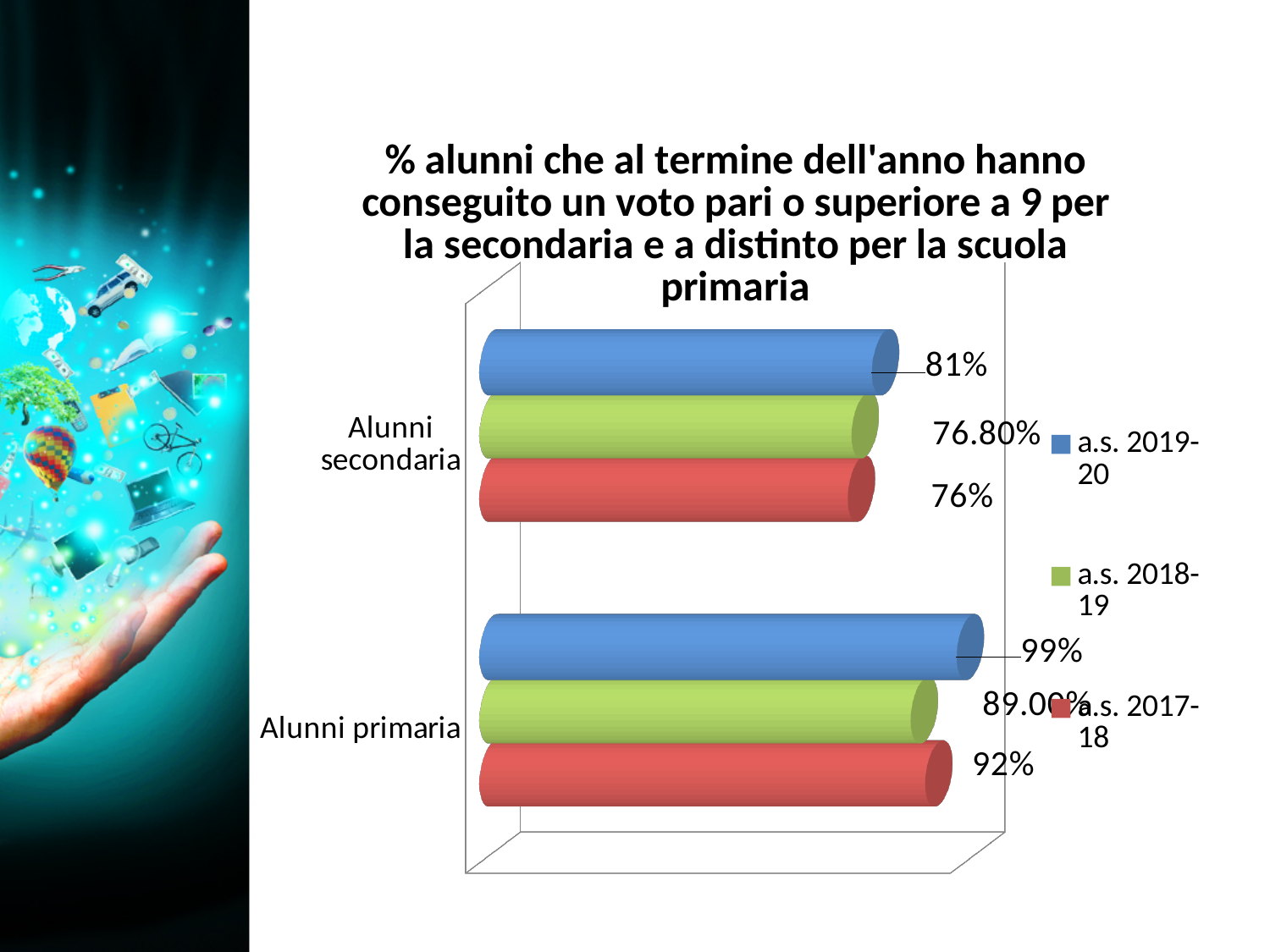
What is the value for Alunni secondaria in a.s. 2017-18? 76% How many series does the legend list? 3 What is the difference between the a.s. 2019-20 values for Alunni primaria and Alunni secondaria? 18% What is the value for Alunni secondaria in a.s. 2019-20? 81% What is the value for Alunni primaria in a.s. 2019-20? 99% How many categories are shown on the chart? 2 Which school year has the highest value for Alunni primaria? a.s. 2019-20 Which colour represents a.s. 2018-19 in the legend? green What kind of chart is shown on the slide? bar chart What is the value for Alunni secondaria in a.s. 2018-19? 76.80% Which school year has the lowest value for Alunni secondaria? a.s. 2017-18 What is the value for Alunni primaria in a.s. 2017-18? 92%